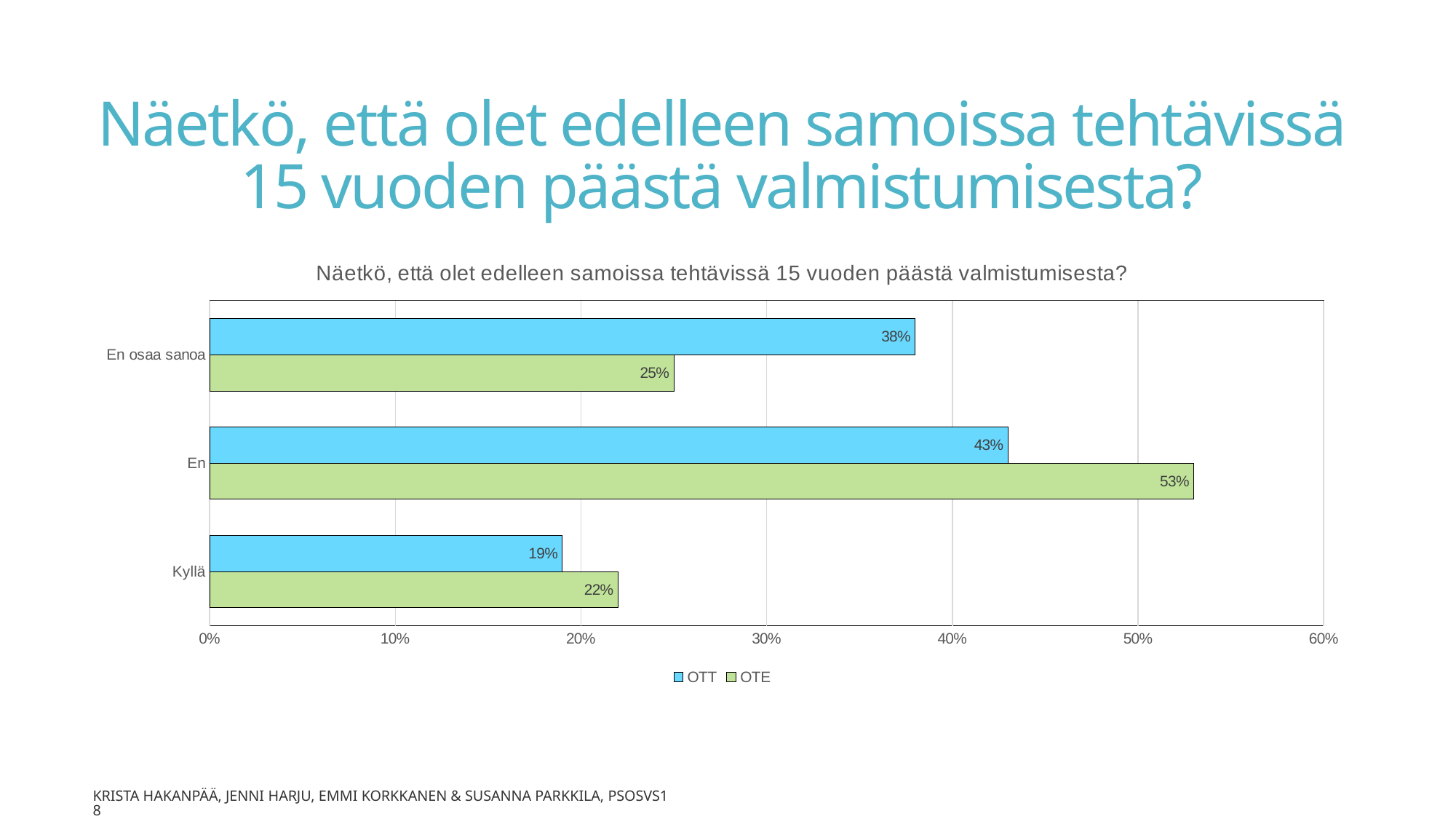
Which category has the lowest OTT value? Kyllä What is the OTE value for "Kyllä"? 22% What kind of chart is shown on the slide? Bar chart How many series does the legend list? 2 Which series is shown in green? OTE What is the difference between the OTE and OTT values for "En"? 10% How many categories are shown on the chart? 3 Which is larger for "En osaa sanoa": the OTT value or the OTE value? OTT What is the OTT value for "En osaa sanoa"? 38% What is the OTT value for "Kyllä"? 19% What is the OTE value for "En"? 53% Which category has the highest OTE value? En